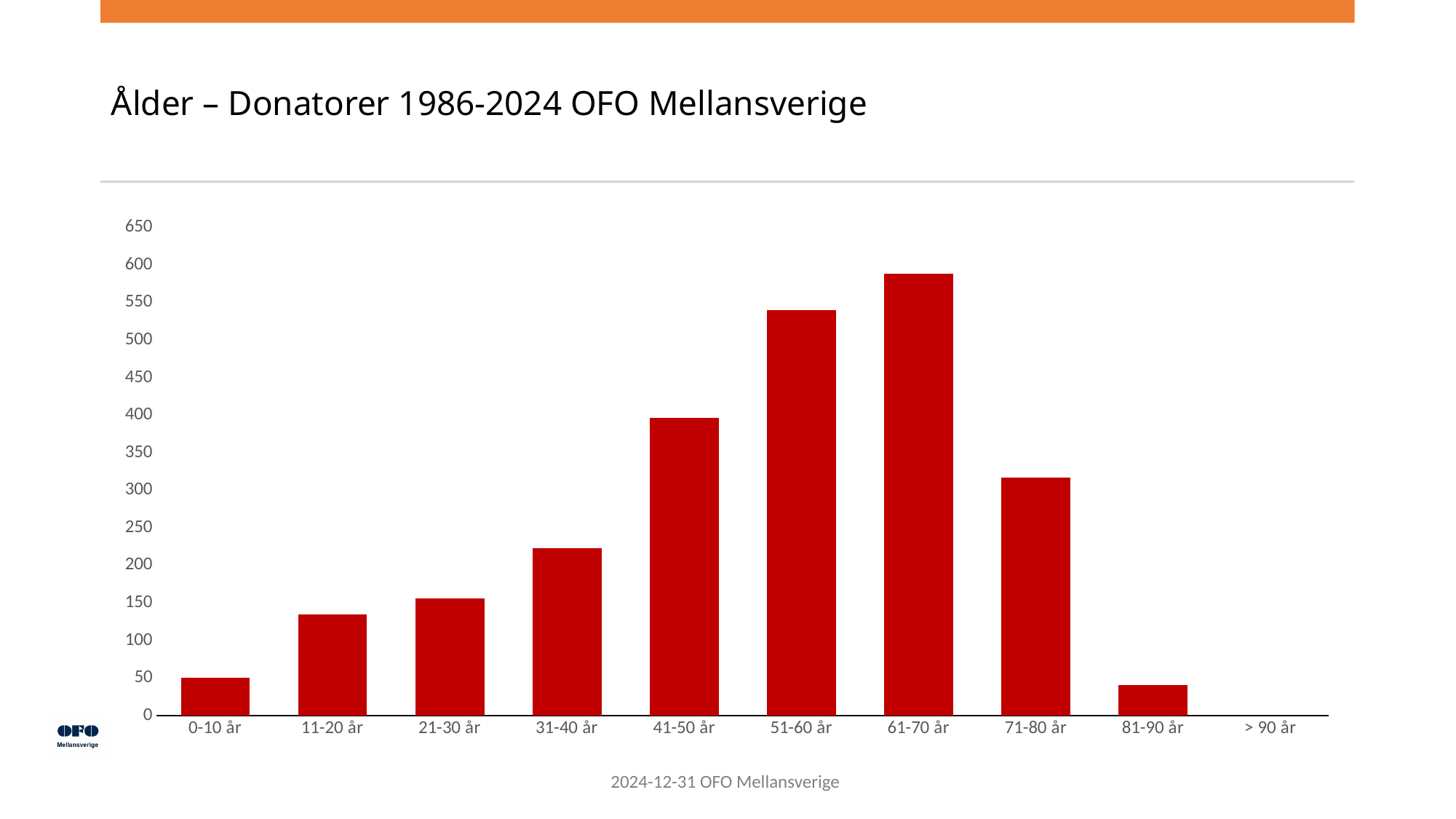
Is the value for 41-50 år greater or less than 350? greater Which age group has no visible bar? > 90 år How many age categories are shown on the x axis? 10 What is the title of the chart on the slide? Ålder – Donatorer 1986-2024 OFO Mellansverige Do the values rise or fall from 0-10 år to 61-70 år along the x axis? rise Is the value for 71-80 år greater or less than 350? less Which age group has the highest bar? 61-70 år What type of chart is shown on the slide? bar chart Which is larger, the value for 31-40 år or the value for 81-90 år? 31-40 år Is the value for 0-10 år greater or less than 100? less Which is larger, the value for 51-60 år or the value for 71-80 år? 51-60 år